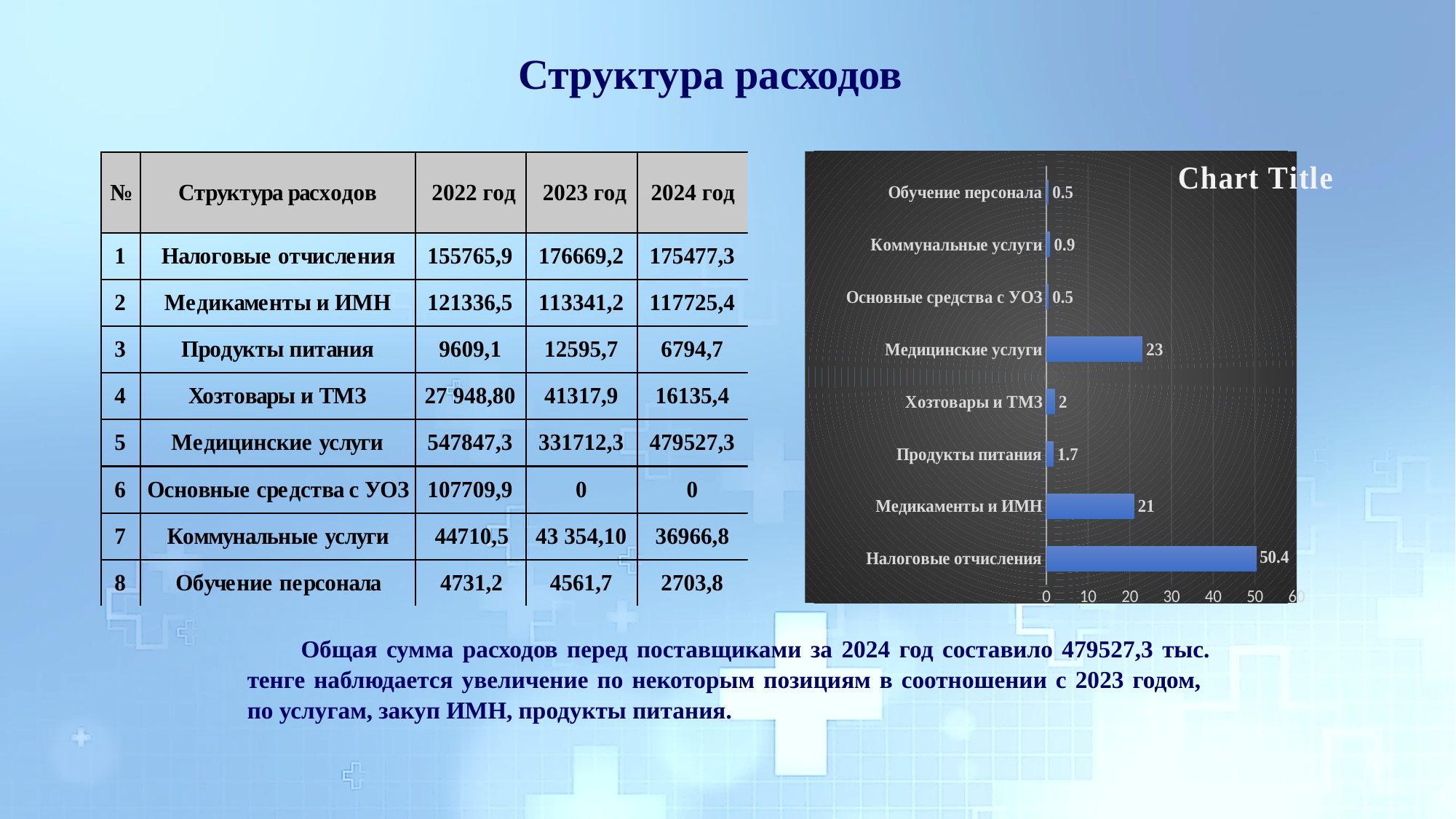
How many categories are shown in the chart? 8 What is the value for Продукты питания in the chart? 1.7 What is the title of the chart? Chart Title What is the value for Коммунальные услуги in the chart? 0.9 What is the value for Медицинские услуги in the chart? 23 Which category has the highest value in the chart? Налоговые отчисления What type of chart is shown on the slide? bar chart Which is larger in the chart: Медицинские услуги or Медикаменты и ИМН? Медицинские услуги Is the value for Налоговые отчисления in the chart greater or less than 40? greater What is the value for Налоговые отчисления in the chart? 50.4 What is the value for Медикаменты и ИМН in the chart? 21 What is the difference between the values for Налоговые отчисления and Медицинские услуги in the chart? 27.4